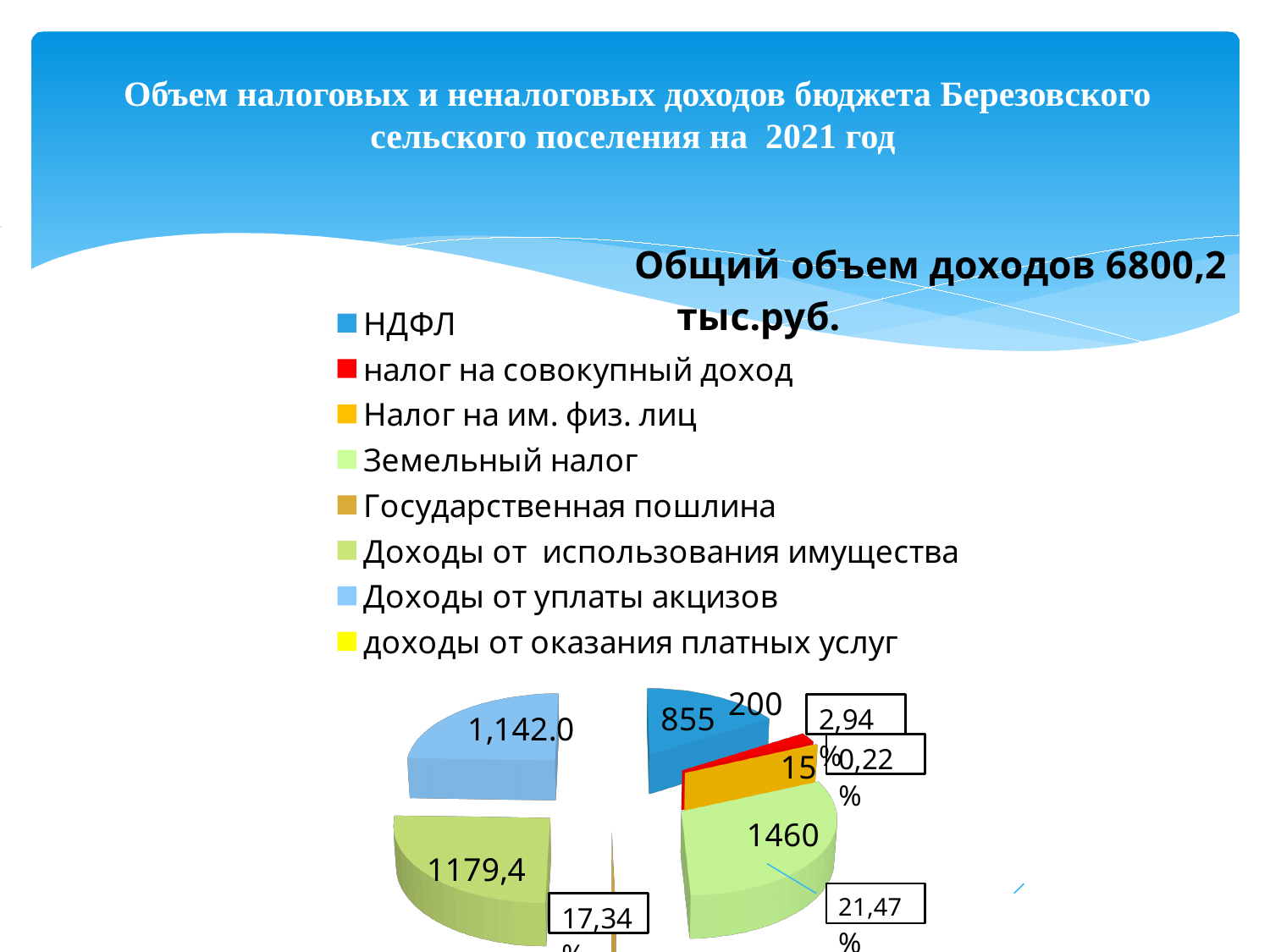
What total revenue amount is stated in the text above the pie chart? 6800,2 тыс.руб. Which is larger on the pie chart: НДФЛ or налог на совокупный доход? НДФЛ Which category has the largest value on the pie chart? Земельный налог What kind of chart is shown on the slide? pie chart What value is shown for Доходы от использования имущества on the pie chart? 1179,4 What value is shown for налог на совокупный доход on the pie chart? 200 What share of the pie does Земельный налог represent, as labelled on the chart? 21,47% What is the difference between the values for Земельный налог and Доходы от использования имущества? 280,6 What value is shown for Доходы от уплаты акцизов on the pie chart? 1,142.0 What value is shown for Земельный налог on the pie chart? 1460 How many entries does the legend of the pie chart list? 8 What value is shown for НДФЛ on the pie chart? 855